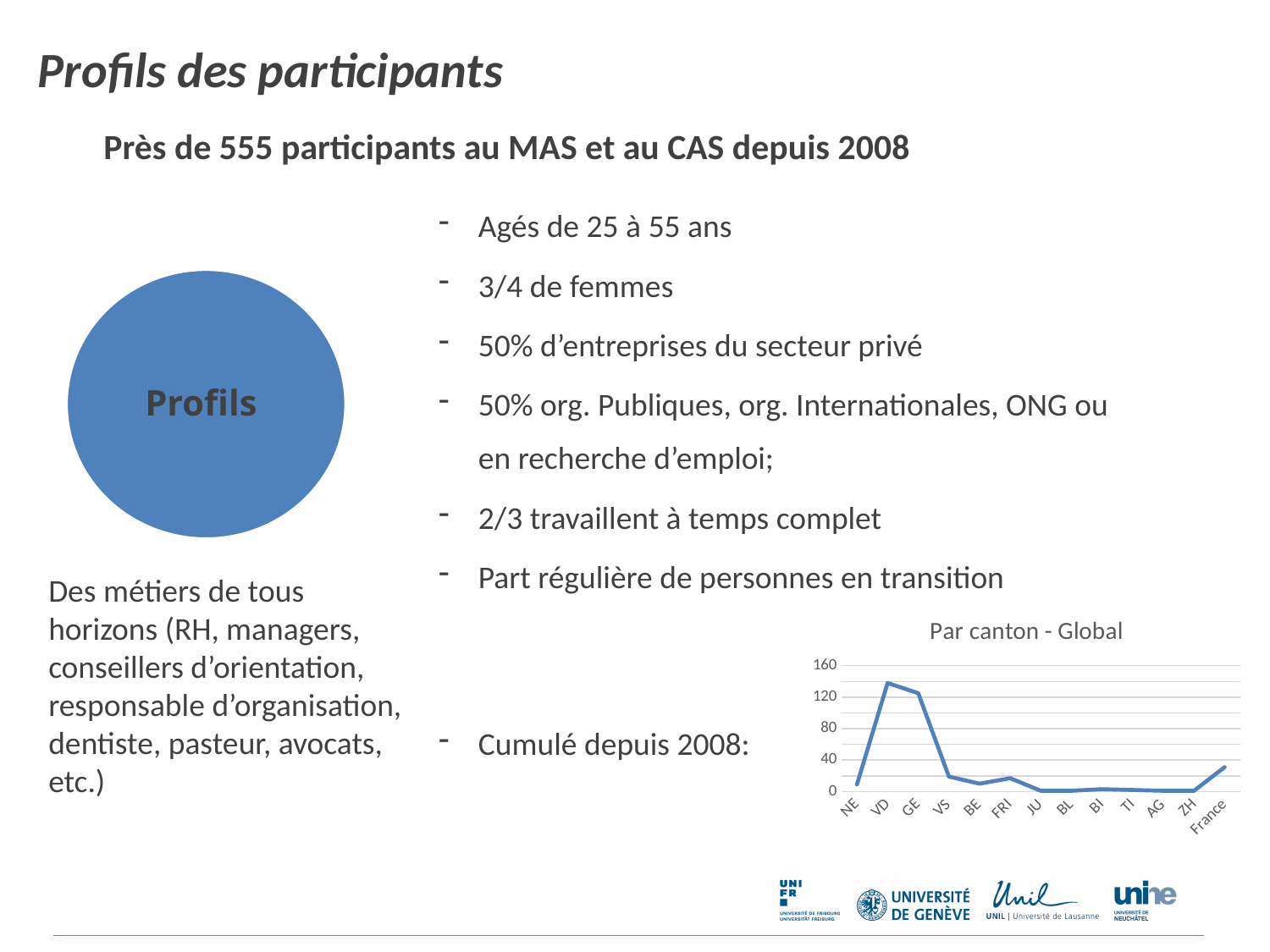
Do the values rise or fall from VD to VS along the x axis? fall Is the value for GE greater or less than 80? greater How many categories are shown on the x axis of the 'Par canton - Global' chart? 13 Is the value for France greater or less than 40? less Which has a larger value, VD or VS? VD Is the value for VD greater or less than 120? greater Which category has the highest value in the 'Par canton - Global' chart? VD What kind of chart is the 'Par canton - Global' chart? line chart What is the title of the chart on the slide? Par canton - Global Which has a larger value, GE or France? GE